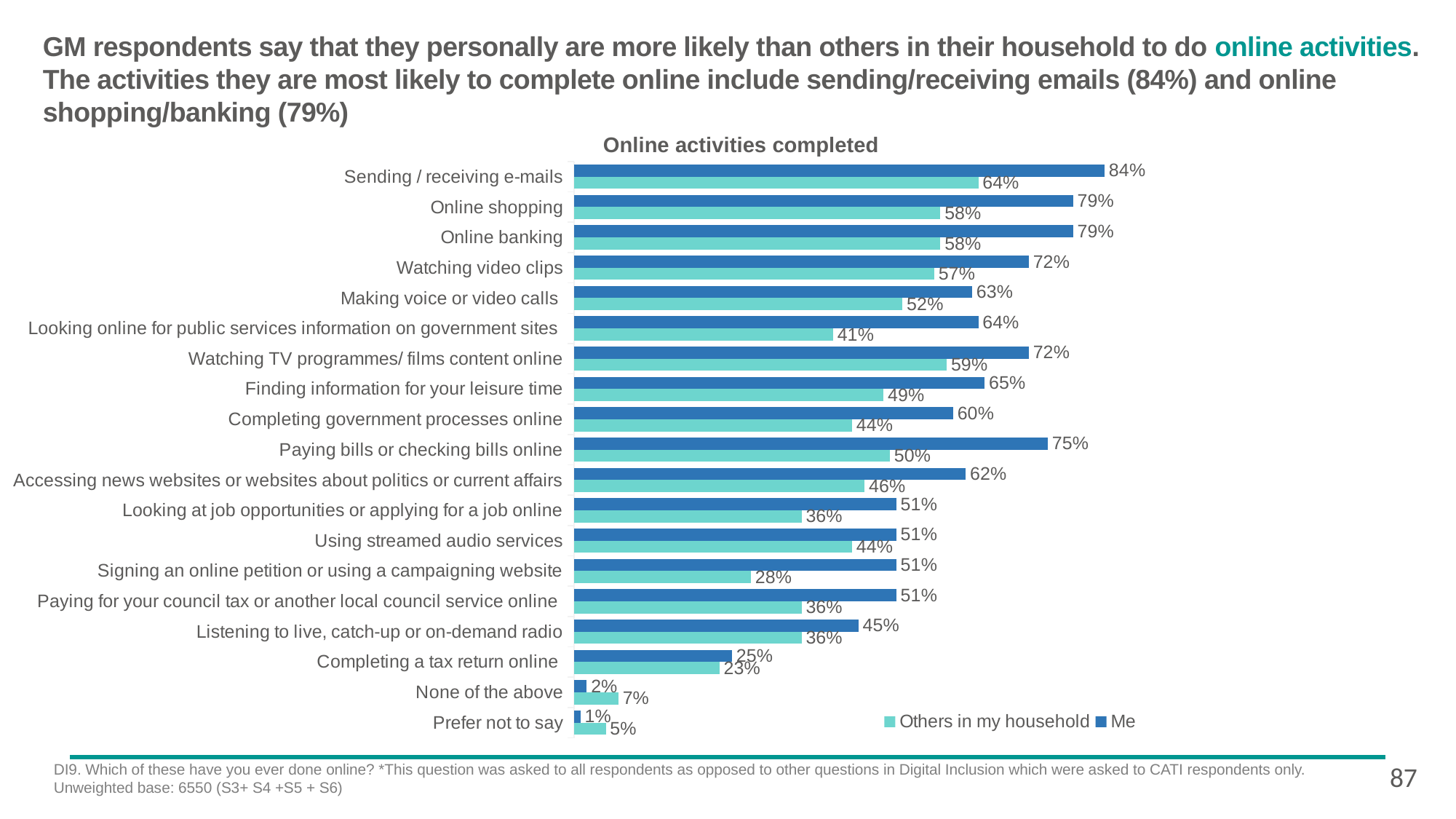
Which is larger: the "Me" value for Watching video clips or the "Me" value for Making voice or video calls? Watching video clips How many categories are shown on the chart? 19 What is the value for "Me" for Paying bills or checking bills online? 75% What kind of chart is shown on the slide? Bar chart For None of the above, which is larger: the "Me" value or the "Others in my household" value? Others in my household How many series does the legend list? 2 What is the difference between the "Me" and "Others in my household" values for Looking online for public services information on government sites? 23 percentage points What is the value for "Others in my household" for Signing an online petition or using a campaigning website? 28% Which category has the lowest value for "Me"? Prefer not to say What is the value for "Me" for Sending / receiving e-mails? 84% What is the title of the chart? Online activities completed Which activity has the highest value for "Me"? Sending / receiving e-mails